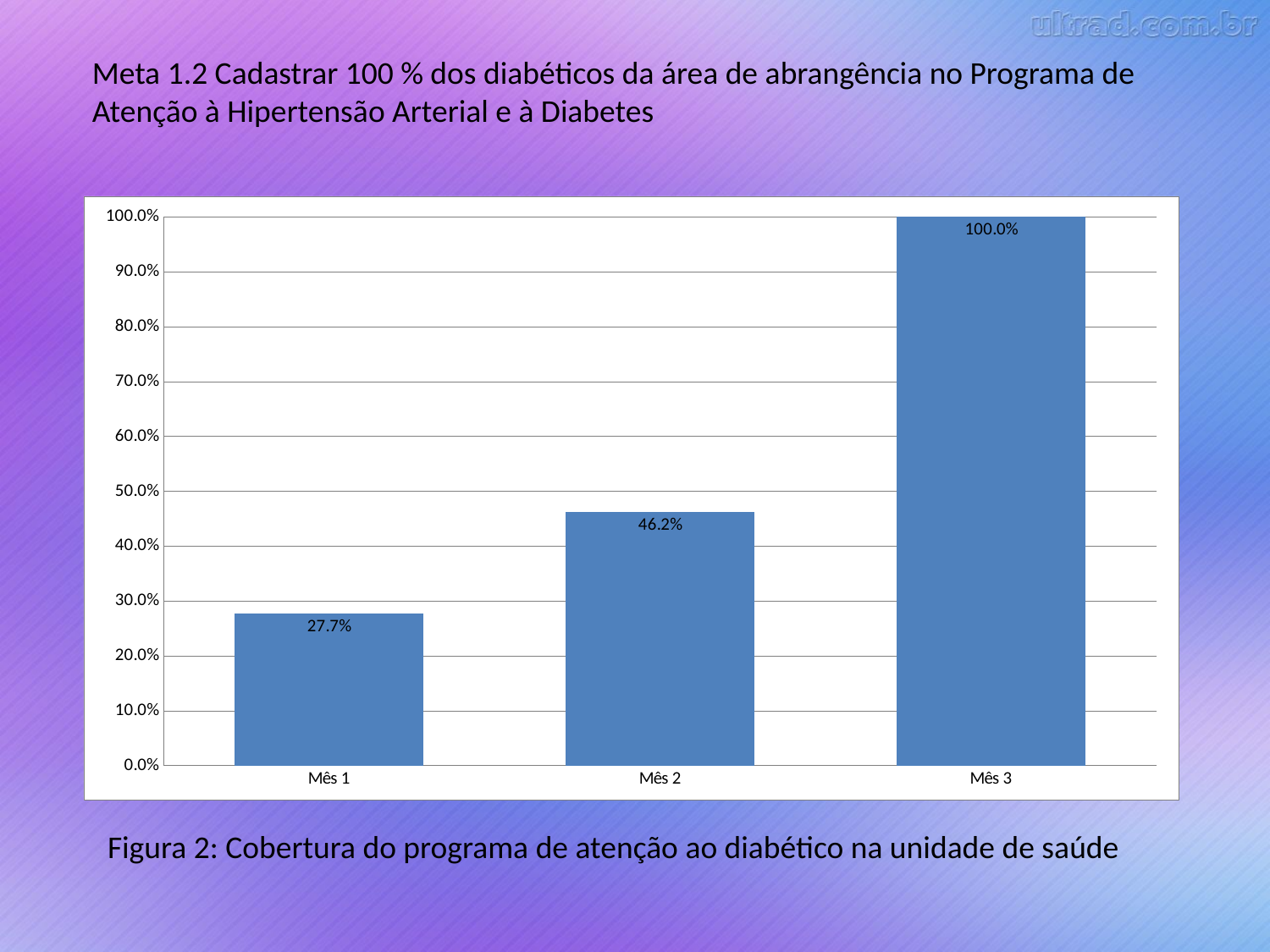
Is the value for Mês 2 greater or less than 50.0%? less Which month has the lowest value? Mês 1 How many categories are shown on the x axis? 3 What is the value for Mês 2? 46.2% What is the value for Mês 3? 100.0% What kind of chart is shown on the slide? bar chart What is the value for Mês 1? 27.7% Do the values rise or fall from Mês 1 to Mês 3? rise Which month has the highest value? Mês 3 What is the difference between the values for Mês 2 and Mês 1? 18.5% What is the difference between the values for Mês 3 and Mês 2? 53.8% Which is larger, the value for Mês 1 or the value for Mês 2? Mês 2